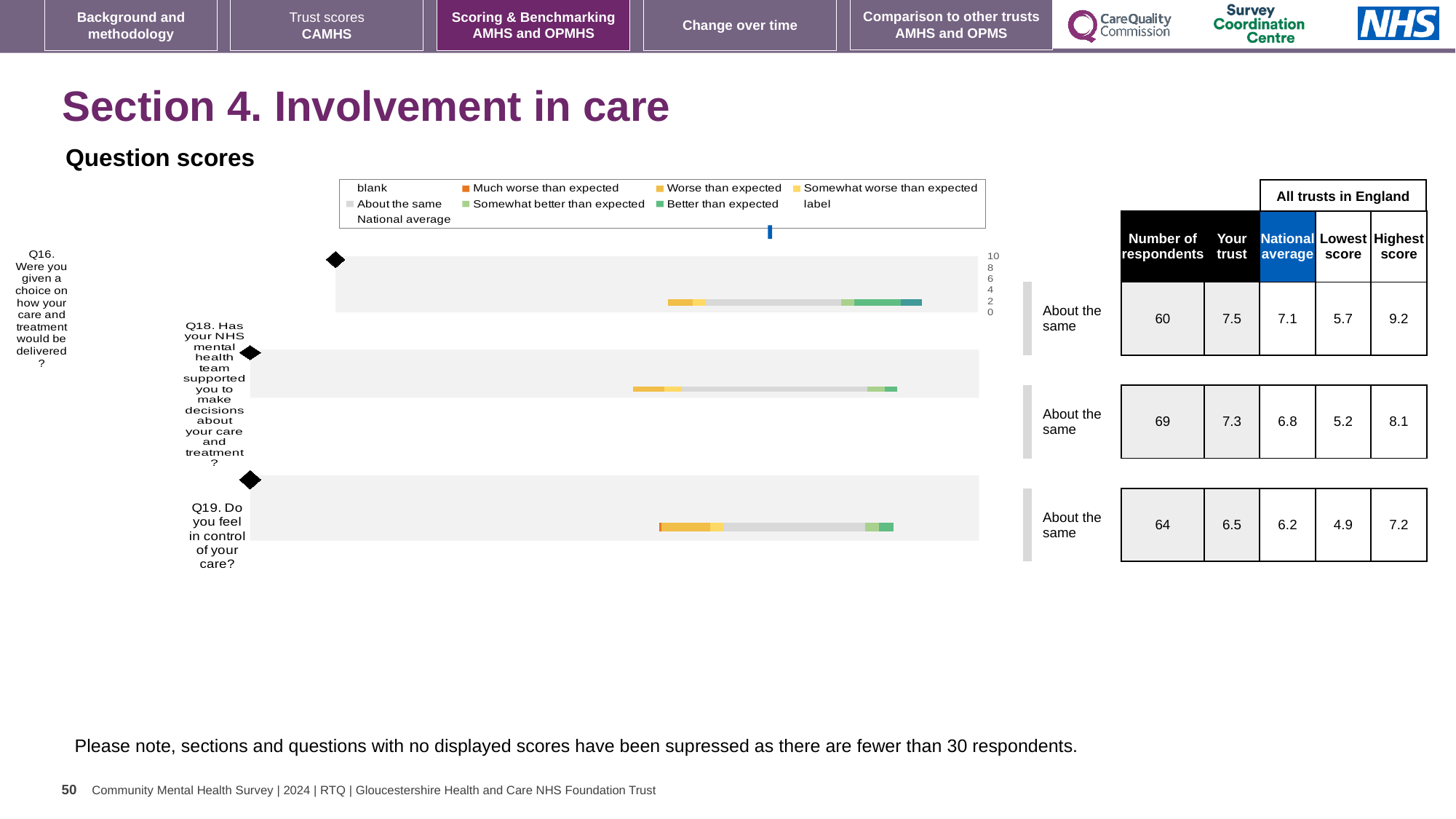
Which question has the highest 'Your trust' score? Q16 Which question has the lowest 'Lowest score' across all trusts in England? Q19 How many respondents answered Q19 (Do you feel in control of your care?)? 64 What kind of chart is used to show the question scores? Bar chart What is the difference between the 'Your trust' score and the national average for Q16? 0.4 Which has the larger 'Your trust' score, Q18 or Q19? Q18 What is the 'Your trust' score for Q16 (Were you given a choice on how your care and treatment would be delivered?)? 7.5 What is the difference between the highest score and the lowest score for Q19? 2.3 What is the national average score for Q18 (Has your NHS mental health team supported you to make decisions about your care and treatment?)? 6.8 How many questions are charted in the Question scores section? 3 What benchmark category is shown for Q19 (Do you feel in control of your care?)? About the same What is the highest score across all trusts in England for Q16? 9.2